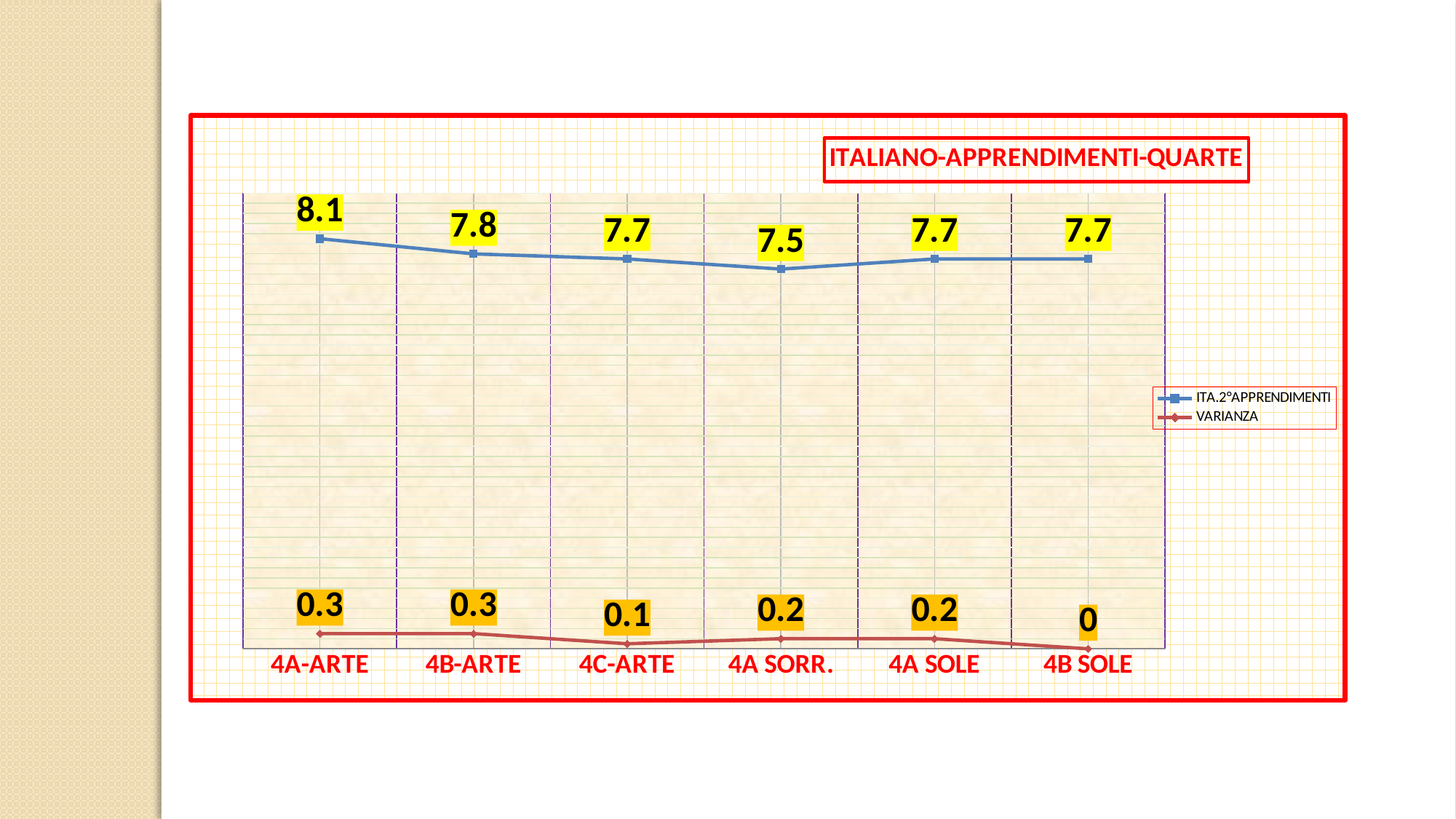
What is the difference between the ITA.2°APPRENDIMENTI values for 4A-ARTE and 4A SORR.? 0.6 Which has a larger VARIANZA value, 4B-ARTE or 4A SOLE? 4B-ARTE What is the ITA.2°APPRENDIMENTI value for 4A-ARTE? 8.1 Which category has the lowest ITA.2°APPRENDIMENTI value? 4A SORR. How many categories are shown on the x axis? 6 What is the ITA.2°APPRENDIMENTI value for 4A SORR.? 7.5 Which category has the highest ITA.2°APPRENDIMENTI value? 4A-ARTE Which category has the lowest VARIANZA value? 4B SOLE How many series does the legend list? 2 What kind of chart is shown on the slide? Line chart What is the VARIANZA value for 4C-ARTE? 0.1 What is the title of the chart? ITALIANO-APPRENDIMENTI-QUARTE